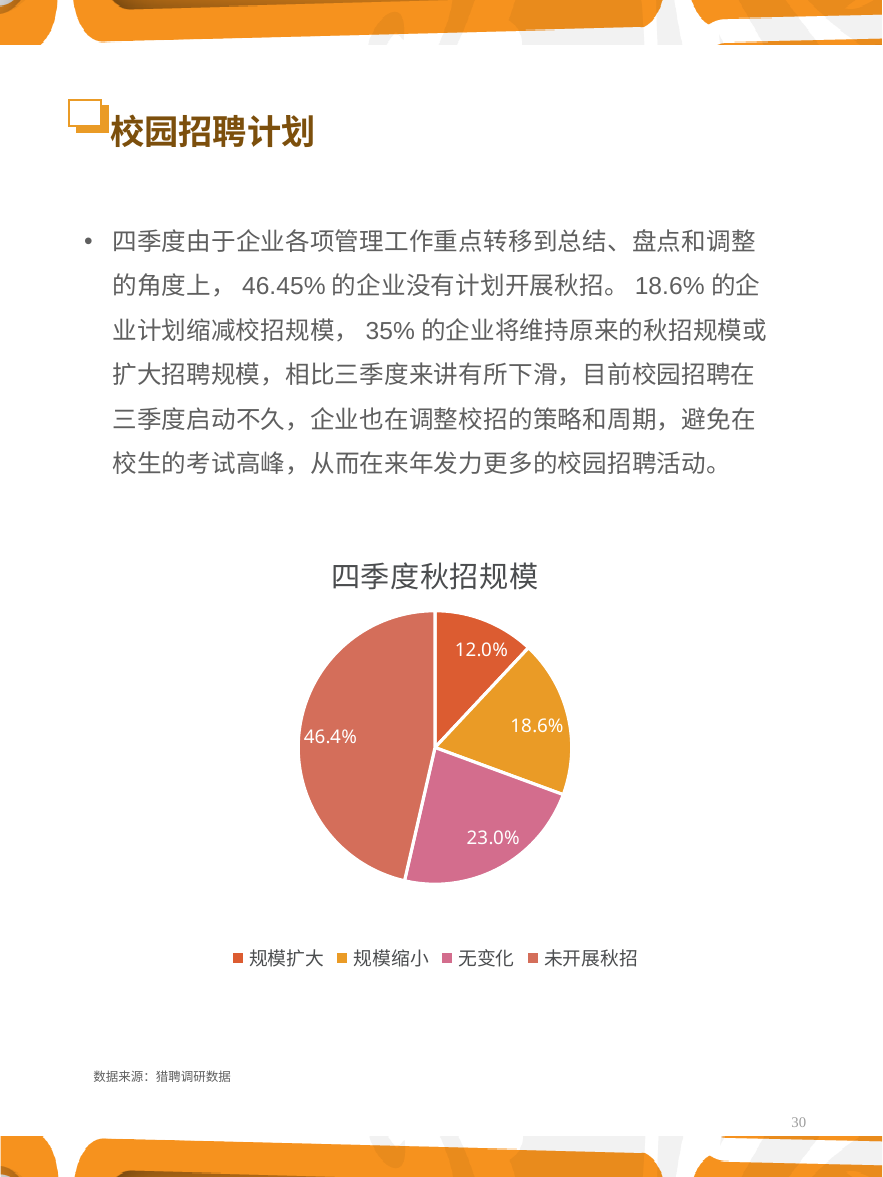
How many entries does the legend list? 4 What percentage of the pie is labelled for 未开展秋招? 46.4% What percentage of the pie is labelled for 规模扩大? 12.0% Which category has the largest share of the pie? 未开展秋招 What type of chart is shown on the slide? pie chart What percentage of the pie is labelled for 规模缩小? 18.6% What is the title of the chart? 四季度秋招规模 What percentage of the pie is labelled for 无变化? 23.0% Which category has the smallest share of the pie? 规模扩大 How many slices does the pie chart have? 4 What is the difference in percentage points between 未开展秋招 and 无变化? 23.4 Which is larger, the share for 无变化 or the share for 规模缩小? 无变化